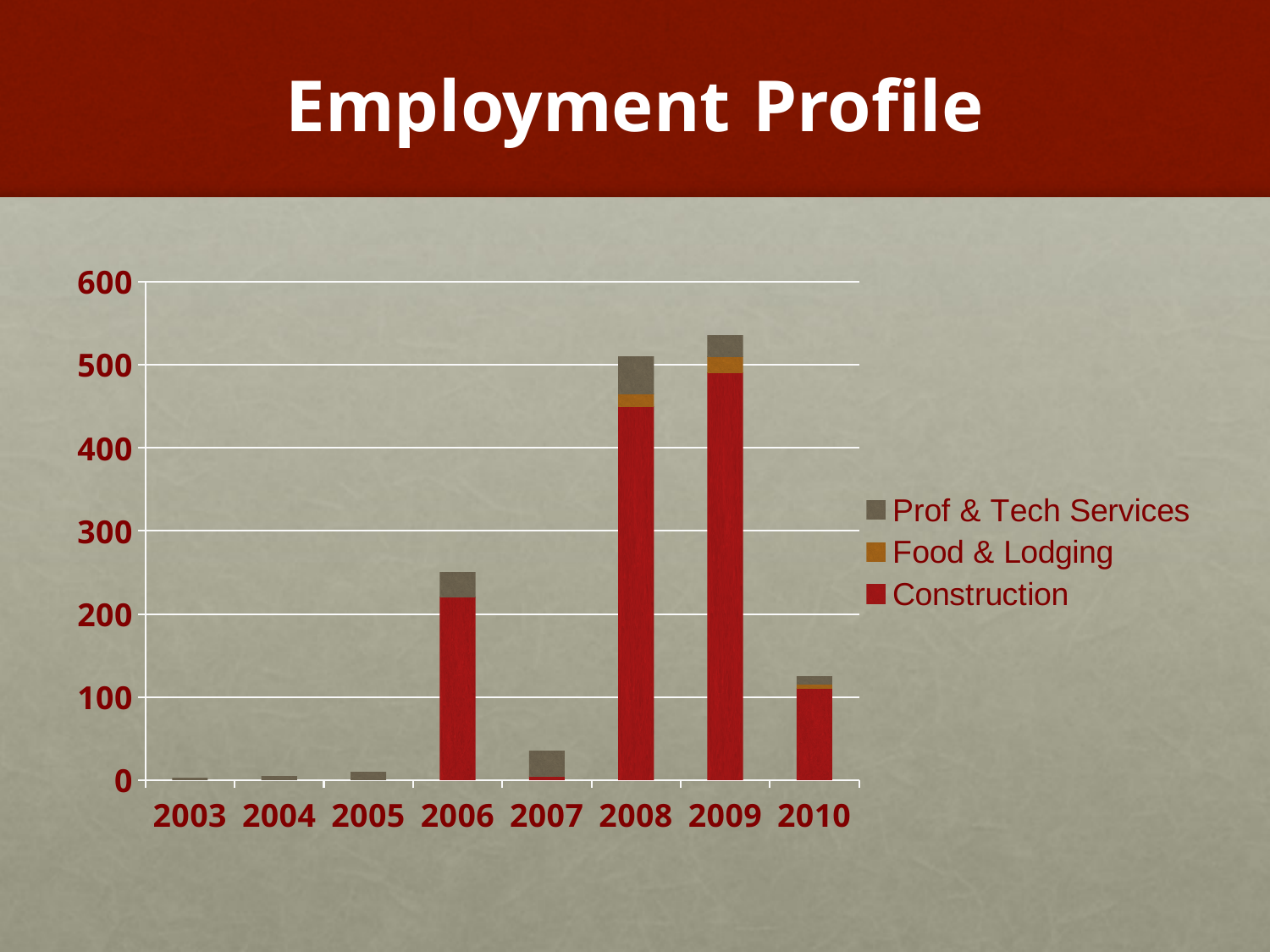
Is the total for 2009 greater or less than 500? greater Is the total for 2006 greater or less than 200? greater Which year has the smallest stacked bar? 2003 Which series is shown in red in the chart? Construction Do the totals rise or fall from 2003 to 2006? rise What kind of chart is shown on the slide? stacked bar chart Which year has the larger total, 2008 or 2006? 2008 Is the Construction value for 2008 greater or less than 500? less How many series does the legend list? 3 Which year has the tallest stacked bar? 2009 How many years are shown on the x axis of the chart? 8